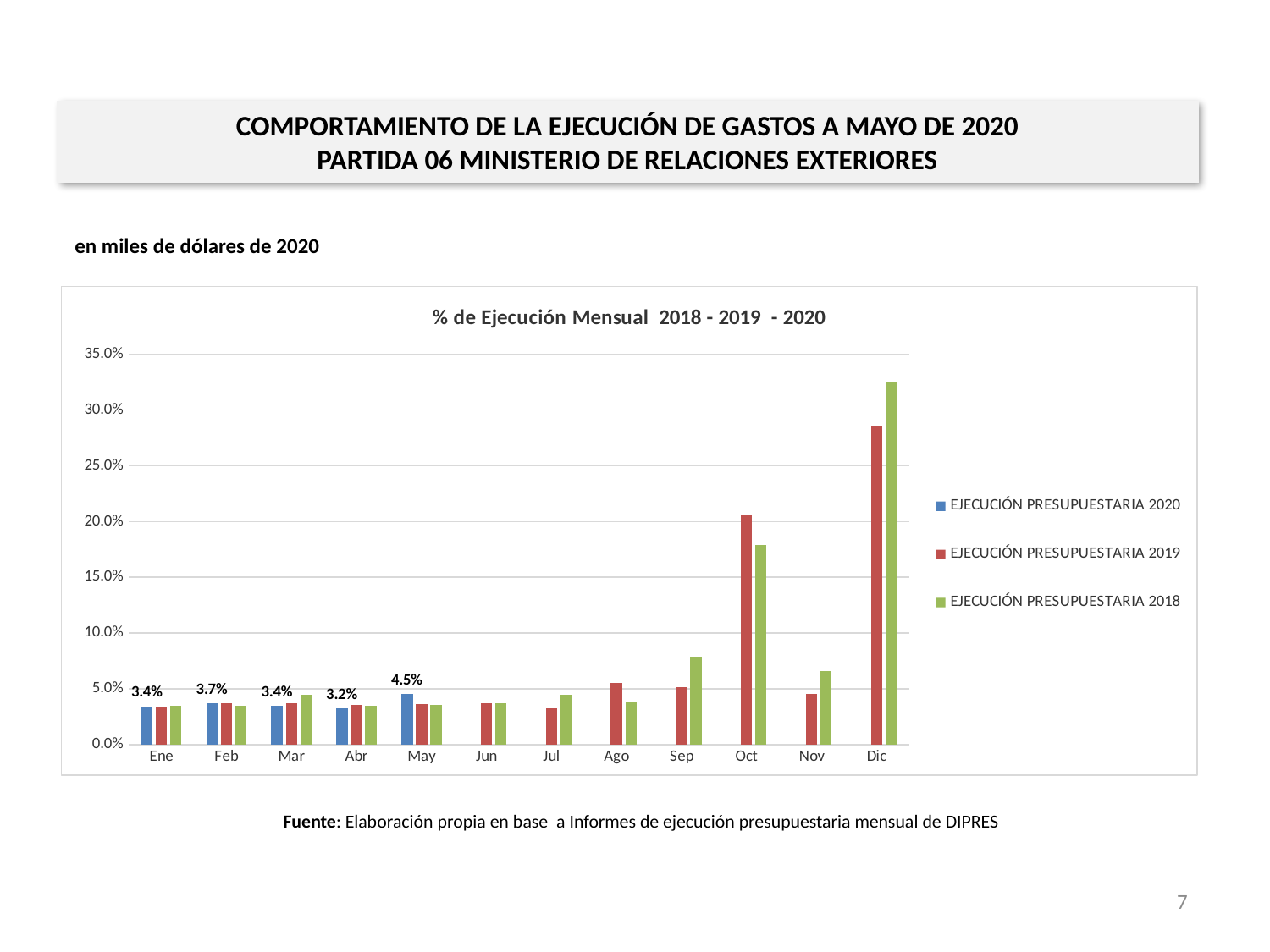
Is the value for EJECUCIÓN PRESUPUESTARIA 2018 in Dic greater or less than 30.0%? greater How many months are shown on the x axis of the chart? 12 What is the title of the chart? % de Ejecución Mensual 2018 - 2019 - 2020 What is the value for EJECUCIÓN PRESUPUESTARIA 2020 in Feb? 3.7% What is the value for EJECUCIÓN PRESUPUESTARIA 2020 in Abr? 3.2% What kind of chart is shown on the slide? bar chart How many series does the legend list? 3 Which month has the highest value for EJECUCIÓN PRESUPUESTARIA 2020? May What is the difference between the EJECUCIÓN PRESUPUESTARIA 2020 values for May and Abr? 1.3% What is the value for EJECUCIÓN PRESUPUESTARIA 2020 in May? 4.5% Which is larger in Oct: EJECUCIÓN PRESUPUESTARIA 2019 or EJECUCIÓN PRESUPUESTARIA 2018? EJECUCIÓN PRESUPUESTARIA 2019 Which month has the lowest value for EJECUCIÓN PRESUPUESTARIA 2020? Abr